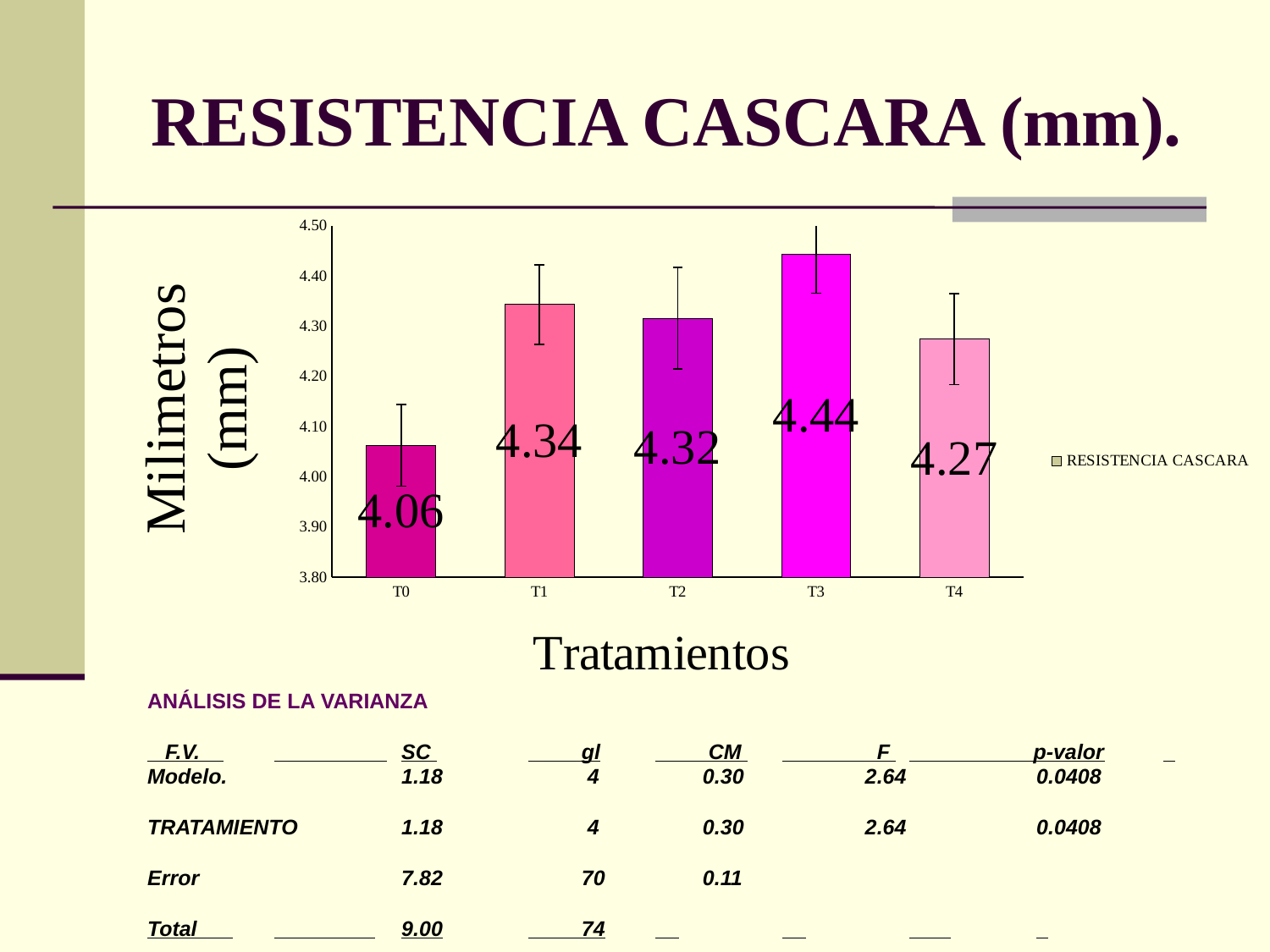
How many series does the legend list? 1 What kind of chart is shown? bar chart Which is larger, the value for T1 or the value for T4? T1 What is the value for T0? 4.06 What is the value for T3? 4.44 Is the value for T2 greater or less than 4.20? greater What is the label of the y axis? Milimetros (mm) Which treatment has the lowest value? T0 What is the value for T4? 4.27 How many treatments are shown on the x axis? 5 Which treatment has the highest value? T3 What is the difference between the values for T3 and T0? 0.38